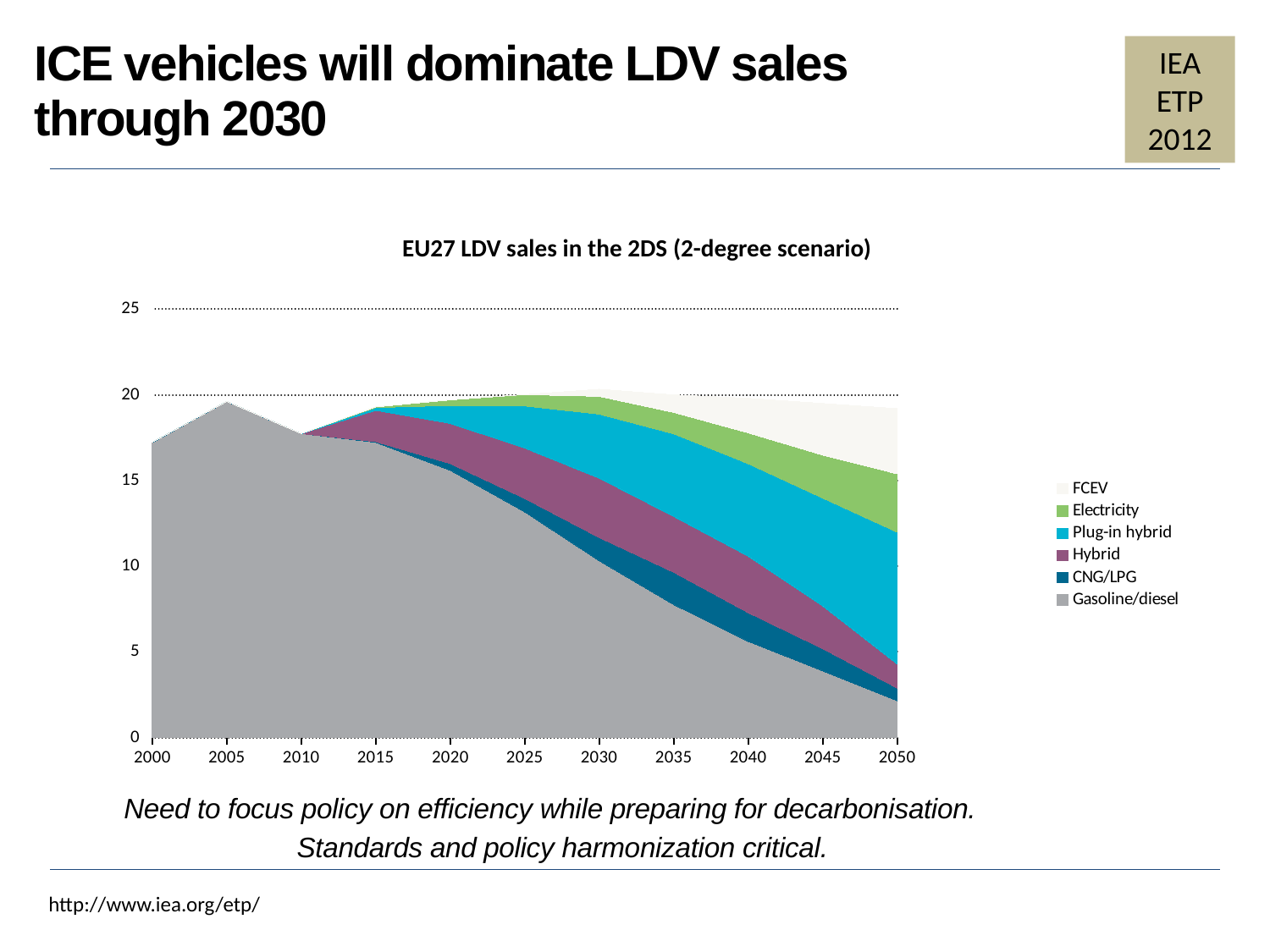
Which series is shown at the bottom of the stacked area chart? Gasoline/diesel Is the value for Gasoline/diesel in 2040 greater or less than 10? less How many year labels are shown on the x axis? 11 What kind of chart is shown on the slide? Stacked area chart In 2050, which is larger: Plug-in hybrid or Gasoline/diesel? Plug-in hybrid Which series accounts for the largest share of sales in 2000? Gasoline/diesel Does the Gasoline/diesel area rise or fall between 2010 and 2050? Fall How many series does the legend list? 6 Is the value for Gasoline/diesel in 2010 greater or less than 15? greater Is the value for Gasoline/diesel in 2050 greater or less than 5? less What is the title of the chart? EU27 LDV sales in the 2DS (2-degree scenario)